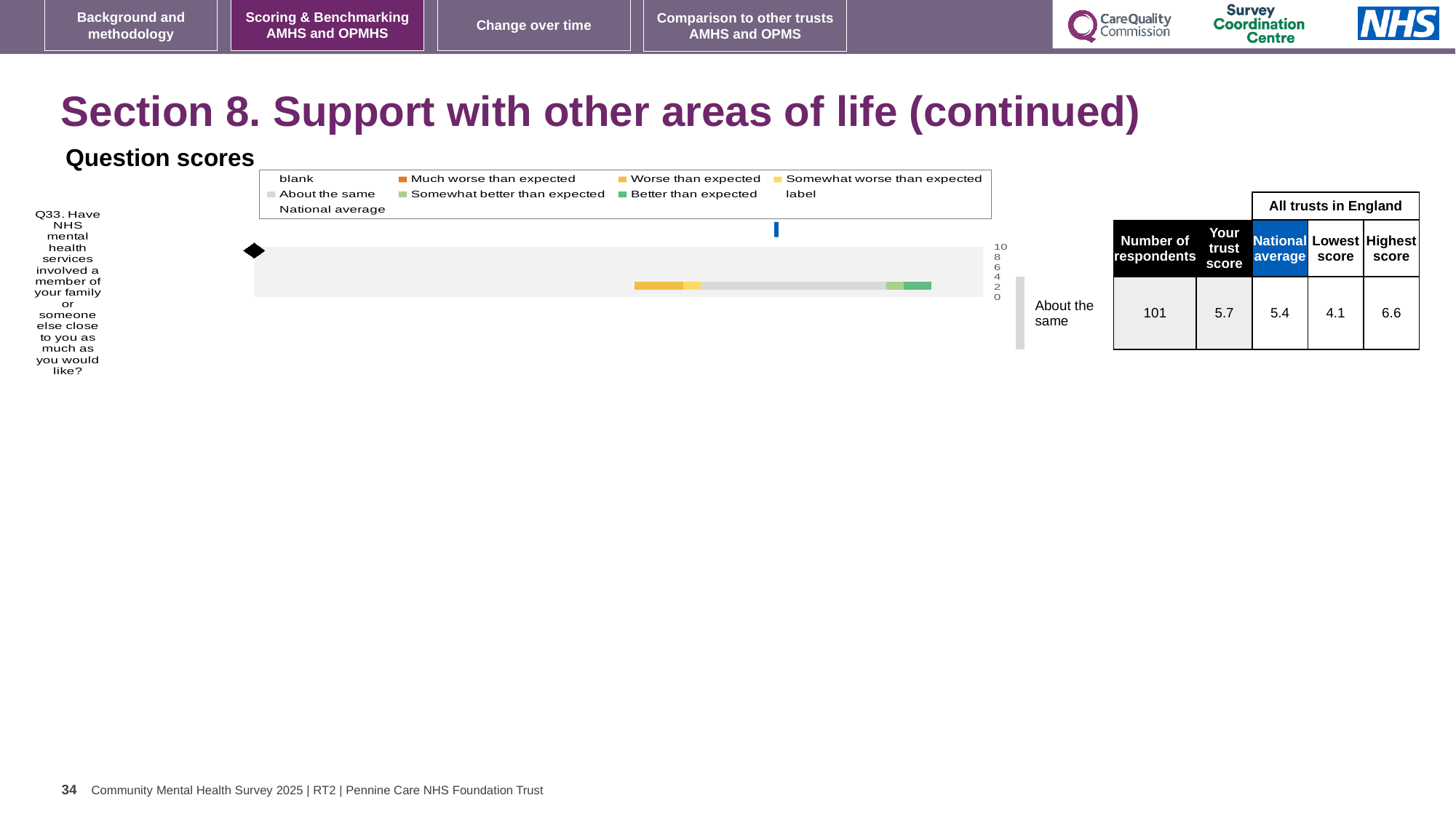
What is the national average score for Q33 shown in the table beside the chart? 5.4 What is the highest score among all trusts in England for Q33? 6.6 In the chart legend, what colour represents 'Better than expected'? green What is the highest value shown on the chart's numeric axis? 10 How many survey questions are plotted in the Question scores chart? 1 For Q33, which is larger: the trust's score or the national average? the trust's score Which benchmark category is the trust's Q33 score placed in, as labelled next to the chart? About the same What is the difference between the highest and lowest scores for Q33 across all trusts in England? 2.5 What kind of chart is used to show the Q33 question score? bar chart According to the table beside the chart, how many respondents answered Q33? 101 What is the trust's score for Q33 shown in the table beside the chart? 5.7 What is the lowest score among all trusts in England for Q33? 4.1